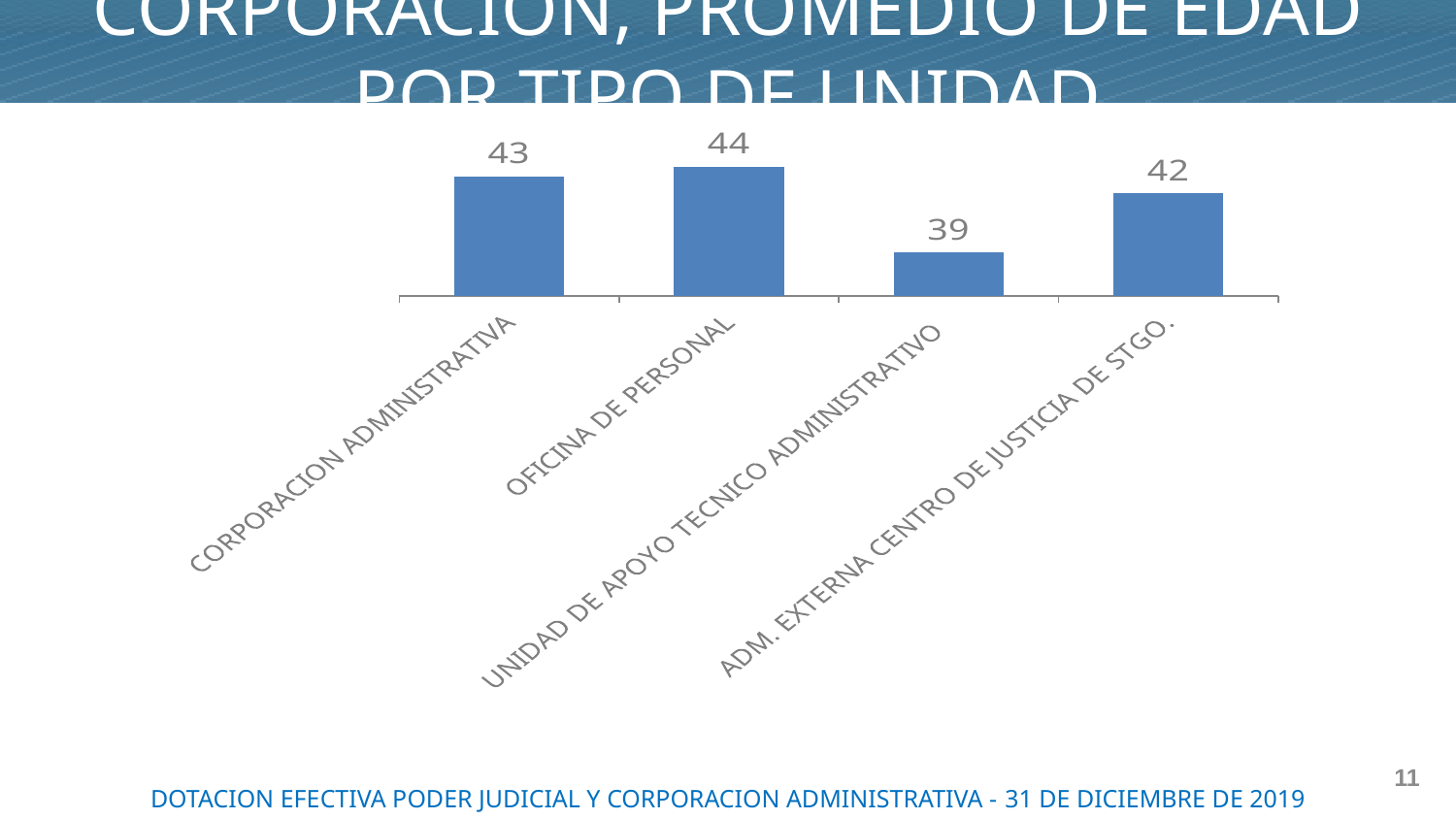
Which category has the highest value? OFICINA DE PERSONAL What colour are the bars in the chart? Blue What is the value shown for ADM. EXTERNA CENTRO DE JUSTICIA DE STGO.? 42 Which category has the lowest value? UNIDAD DE APOYO TECNICO ADMINISTRATIVO What is the difference between the values for OFICINA DE PERSONAL and UNIDAD DE APOYO TECNICO ADMINISTRATIVO? 5 What is the difference between the values for CORPORACION ADMINISTRATIVA and ADM. EXTERNA CENTRO DE JUSTICIA DE STGO.? 1 What kind of chart is shown on the slide? Bar chart Which is larger, the value for CORPORACION ADMINISTRATIVA or the value for UNIDAD DE APOYO TECNICO ADMINISTRATIVO? CORPORACION ADMINISTRATIVA What is the value shown for CORPORACION ADMINISTRATIVA? 43 How many categories are shown in the chart? 4 What is the value shown for UNIDAD DE APOYO TECNICO ADMINISTRATIVO? 39 What is the average age shown for OFICINA DE PERSONAL? 44